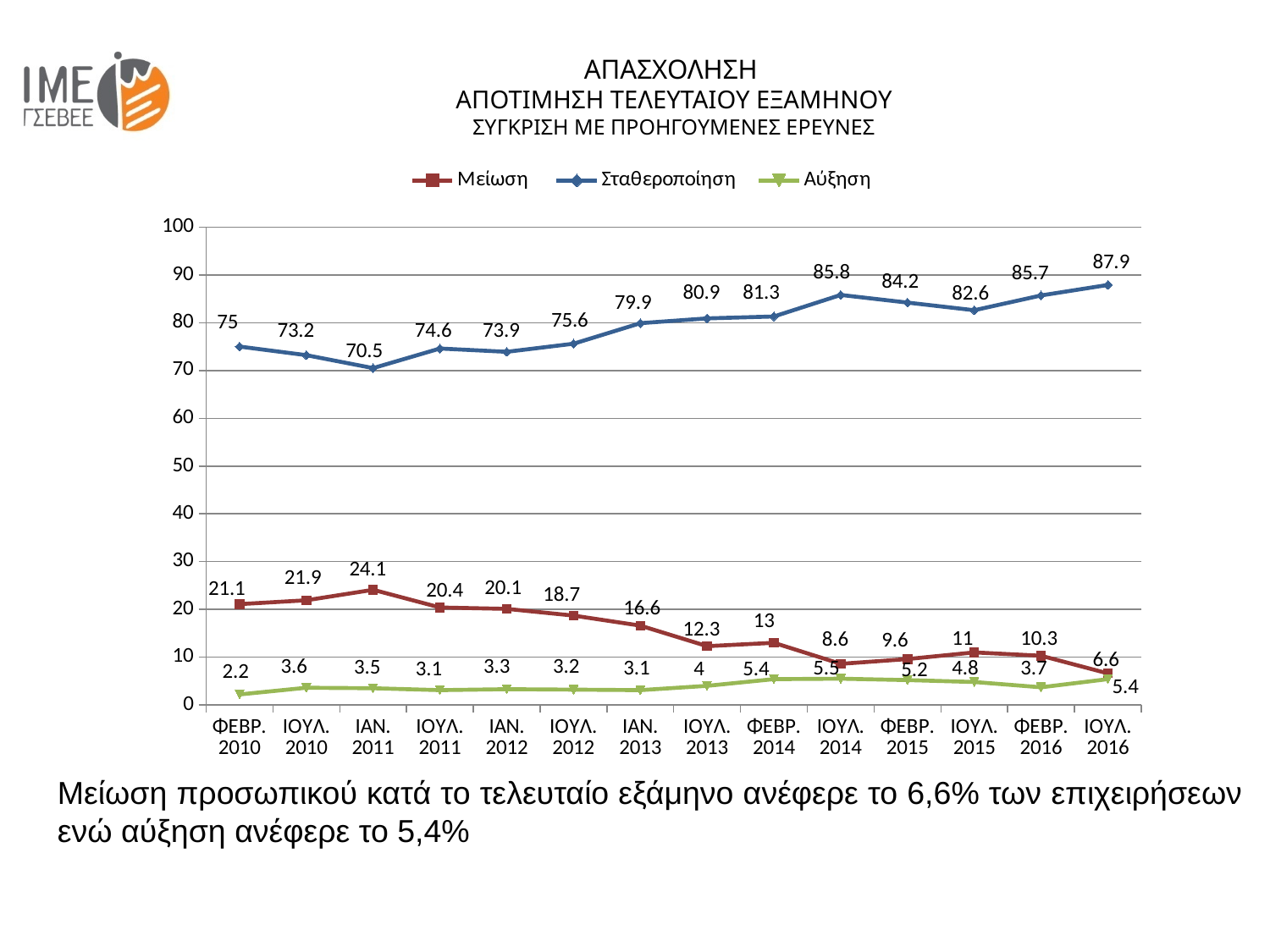
What is the value of Σταθεροποίηση for ΙΟΥΛ. 2016? 87.9 How many time periods are shown on the x axis? 14 In which period does the Μείωση series reach its highest value? ΙΑΝ. 2011 What is the value of Μείωση for ΙΑΝ. 2011? 24.1 What kind of chart is shown on the slide? Line chart In which period does the Σταθεροποίηση series reach its lowest value? ΙΑΝ. 2011 Which is larger for ΙΟΥΛ. 2016: the Μείωση value or the Αύξηση value? Μείωση What is the difference between the Μείωση values for ΦΕΒΡ. 2010 and ΙΟΥΛ. 2016? 14.5 Is the Σταθεροποίηση value for ΙΟΥΛ. 2014 greater or less than 80? greater How many series does the legend list? 3 What is the value of Αύξηση for ΦΕΒΡ. 2010? 2.2 Does the Μείωση series generally rise or fall from ΦΕΒΡ. 2010 to ΙΟΥΛ. 2016? Fall